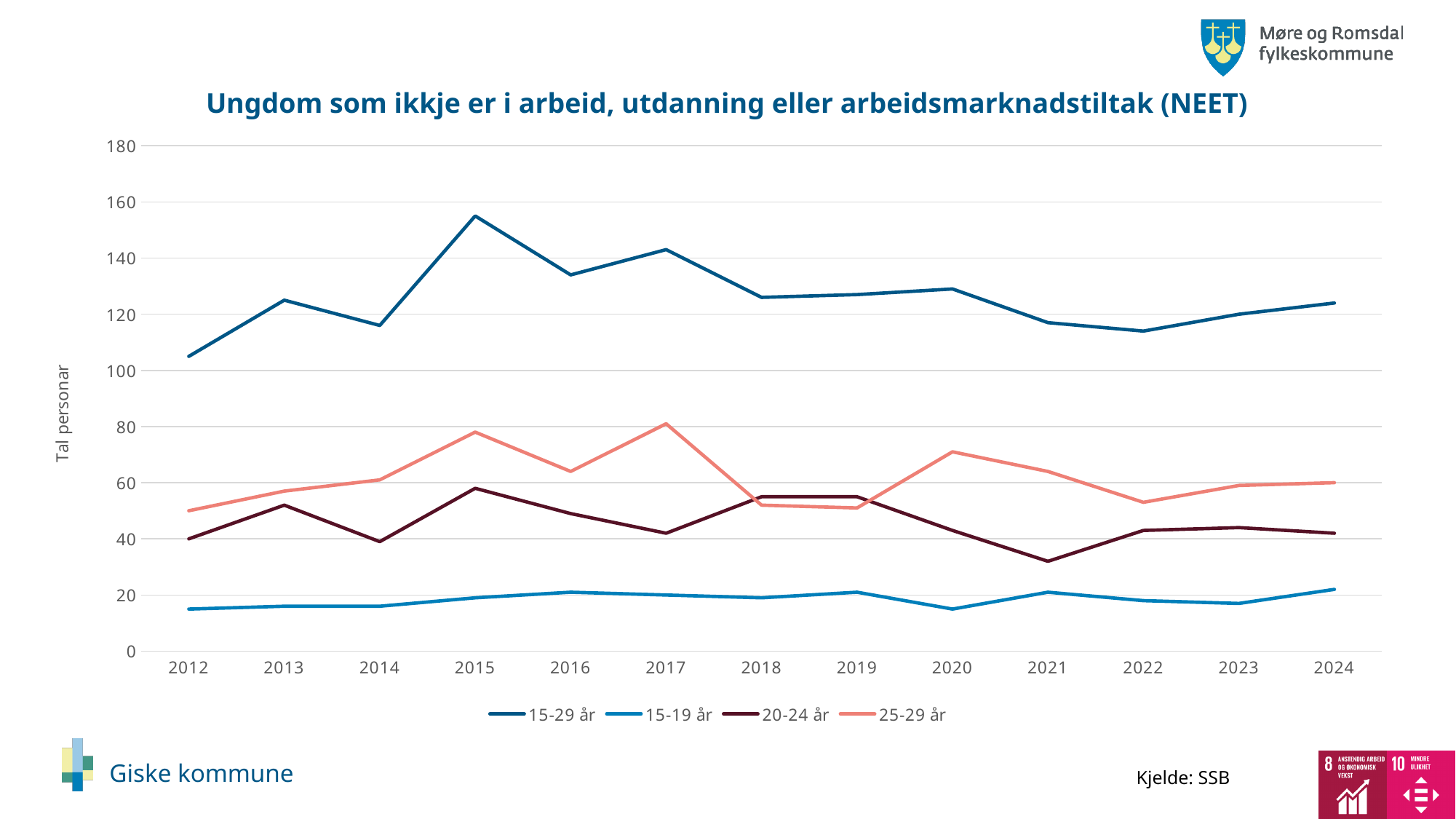
Is the value for 15-19 år in 2016 greater or less than 40? less In which year is the value for 15-29 år lowest? 2012 Is the value for 15-29 år in 2015 greater or less than 140? greater Is the value for 25-29 år in 2017 greater or less than 70? greater What is the label on the y axis? Tal personar In which year is the value for 15-29 år highest? 2015 How many years are shown on the x axis? 13 What kind of chart is shown on the slide? line chart How many series does the legend list? 4 Does the value for 15-29 år rise or fall from 2012 to 2015? rise In 2020, which is larger: 20-24 år or 25-29 år? 25-29 år